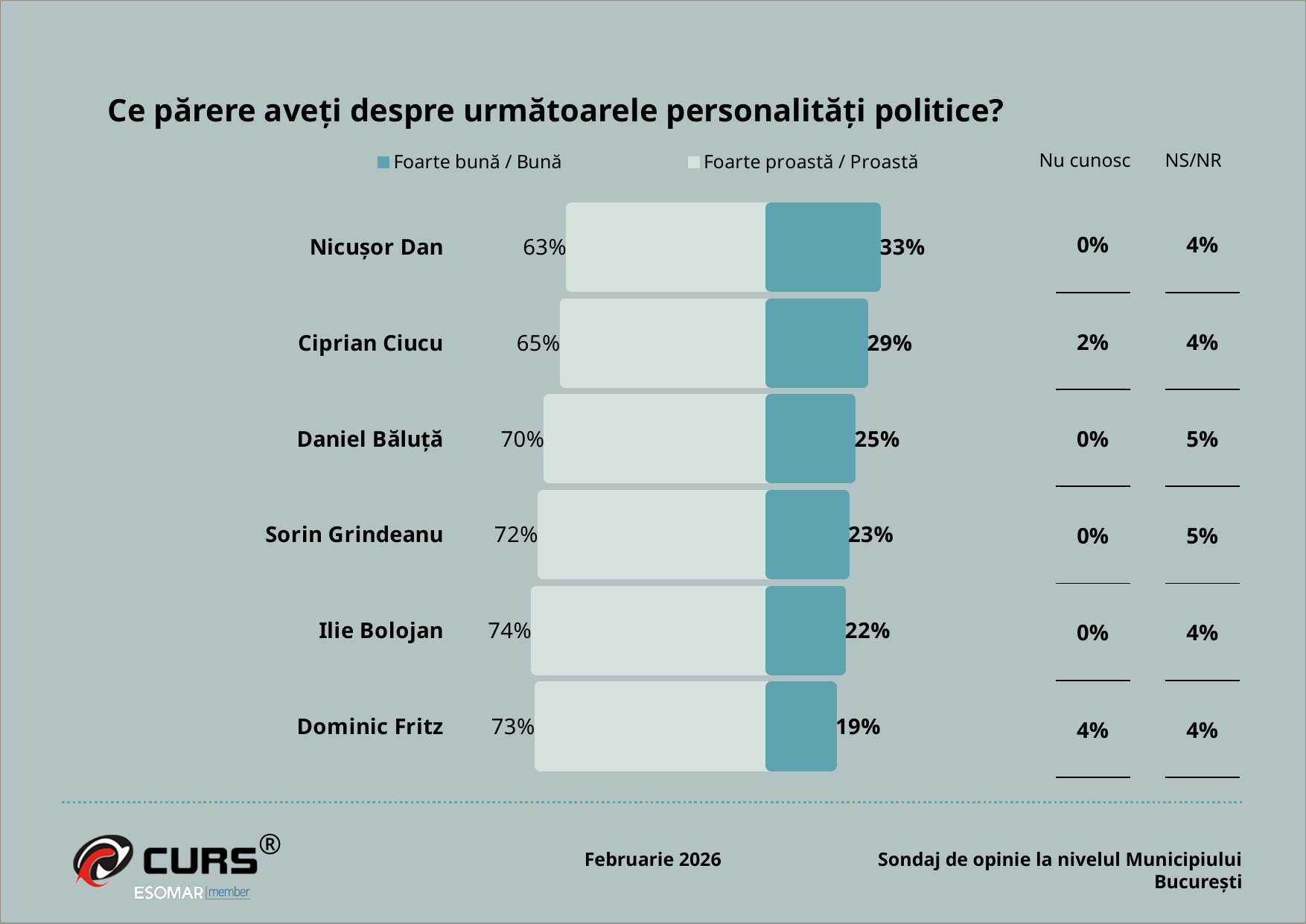
How many series does the legend list? 2 Which politician has the highest 'Foarte bună / Bună' value? Nicușor Dan What is the 'Nu cunosc' value for Dominic Fritz? 4% Who has a higher 'Foarte bună / Bună' value, Ciprian Ciucu or Sorin Grindeanu? Ciprian Ciucu What is the difference between the 'Foarte proastă / Proastă' values for Ilie Bolojan and Nicușor Dan? 11% What type of chart is shown on the slide? Bar chart What is the NS/NR value for Daniel Băluță? 5% How many politicians are shown in the chart? 6 What is the 'Foarte proastă / Proastă' value for Ilie Bolojan? 74% Which politician has the lowest 'Foarte proastă / Proastă' value? Nicușor Dan Which politician has the lowest 'Foarte bună / Bună' value? Dominic Fritz What percentage of respondents have a 'Foarte bună / Bună' opinion of Nicușor Dan? 33%